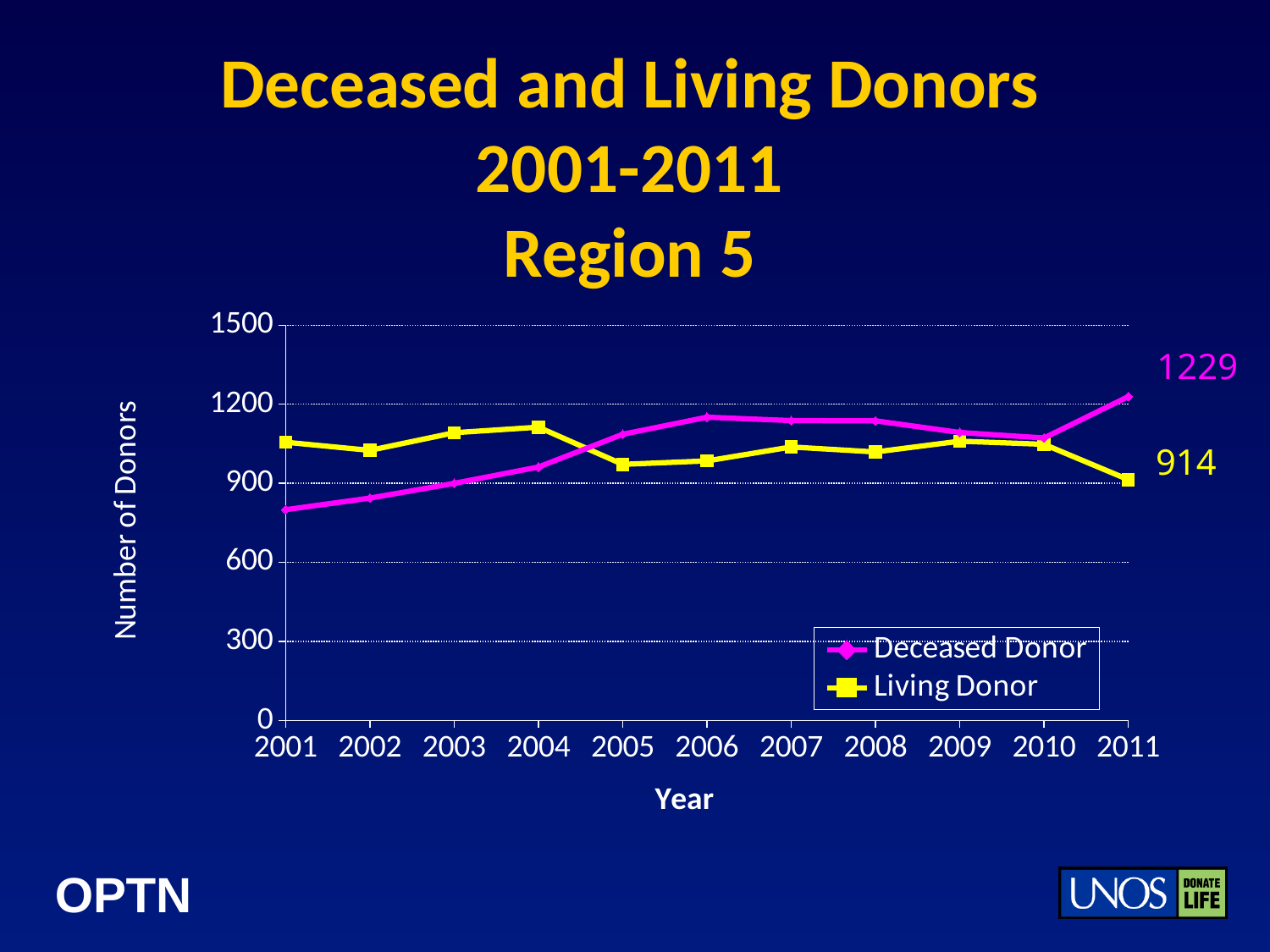
In 2011, which series has the larger value, Deceased Donor or Living Donor? Deceased Donor In 2001, which series has the larger value, Deceased Donor or Living Donor? Living Donor In which year is the Deceased Donor series at its lowest? 2001 In which year is the Deceased Donor series at its highest? 2011 What is the value for Deceased Donor in 2011? 1229 How many series does the legend list? 2 Is the value for Deceased Donor in 2001 greater or less than 900? less Is the value for Living Donor in 2004 greater or less than 900? greater How many years are shown on the x axis? 11 What kind of chart is shown on the slide? line chart What is the difference between the Deceased Donor and Living Donor values in 2011? 315 What is the value for Living Donor in 2011? 914